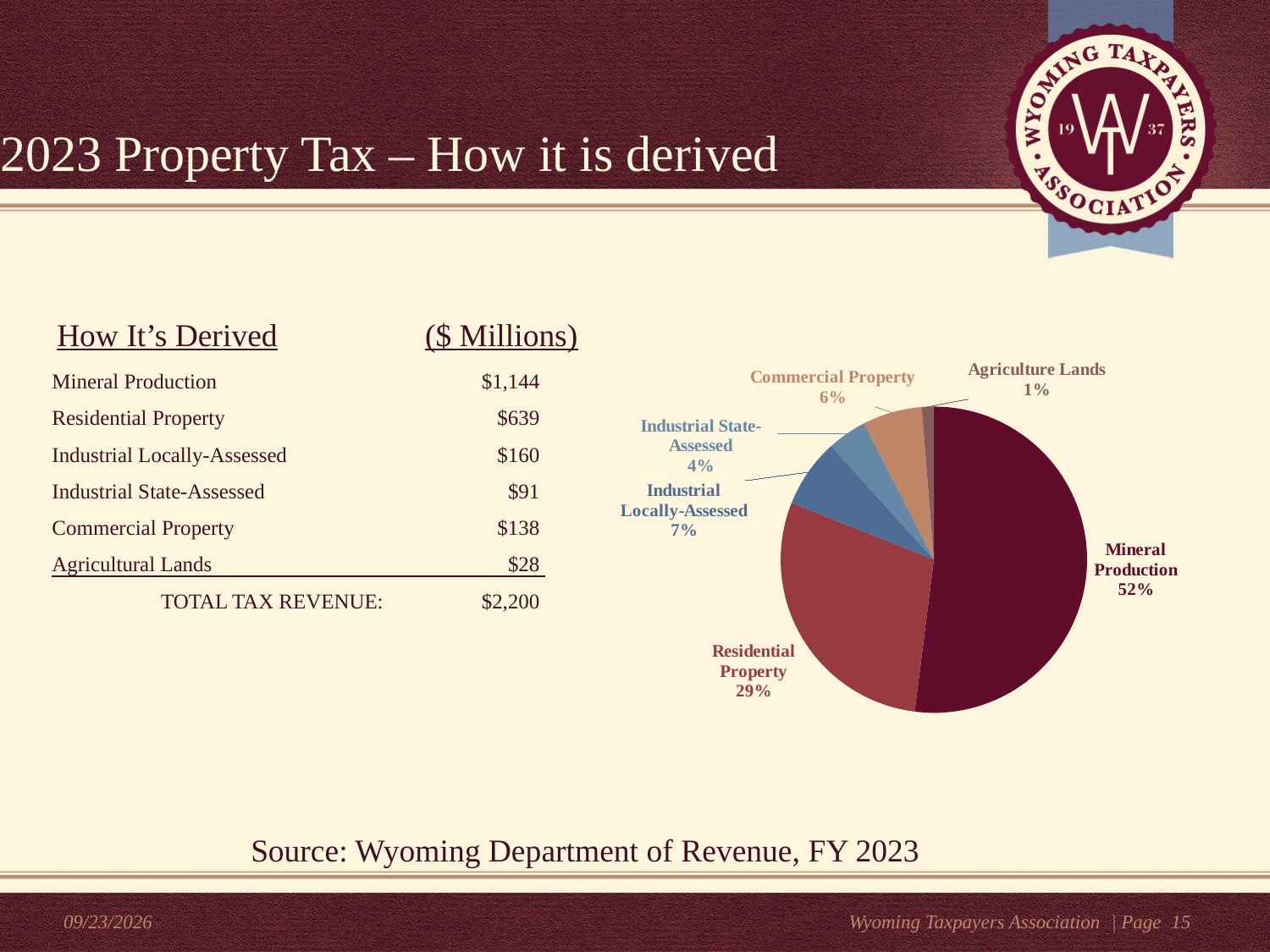
What kind of chart is shown on the slide? pie chart What percentage is shown for Commercial Property? 6% Which category has the smallest slice of the pie? Agriculture Lands Which is larger, the slice for Commercial Property or the slice for Industrial State-Assessed? Commercial Property What share of the pie does Mineral Production represent? 52% What is the difference in percentage points between Mineral Production and Residential Property? 23 How many slices does the pie chart have? 6 What percentage is shown for Agriculture Lands? 1% What share of the pie does Residential Property represent? 29% Which category has the largest slice of the pie? Mineral Production What percentage is shown for Industrial State-Assessed? 4% What percentage is shown for Industrial Locally-Assessed? 7%